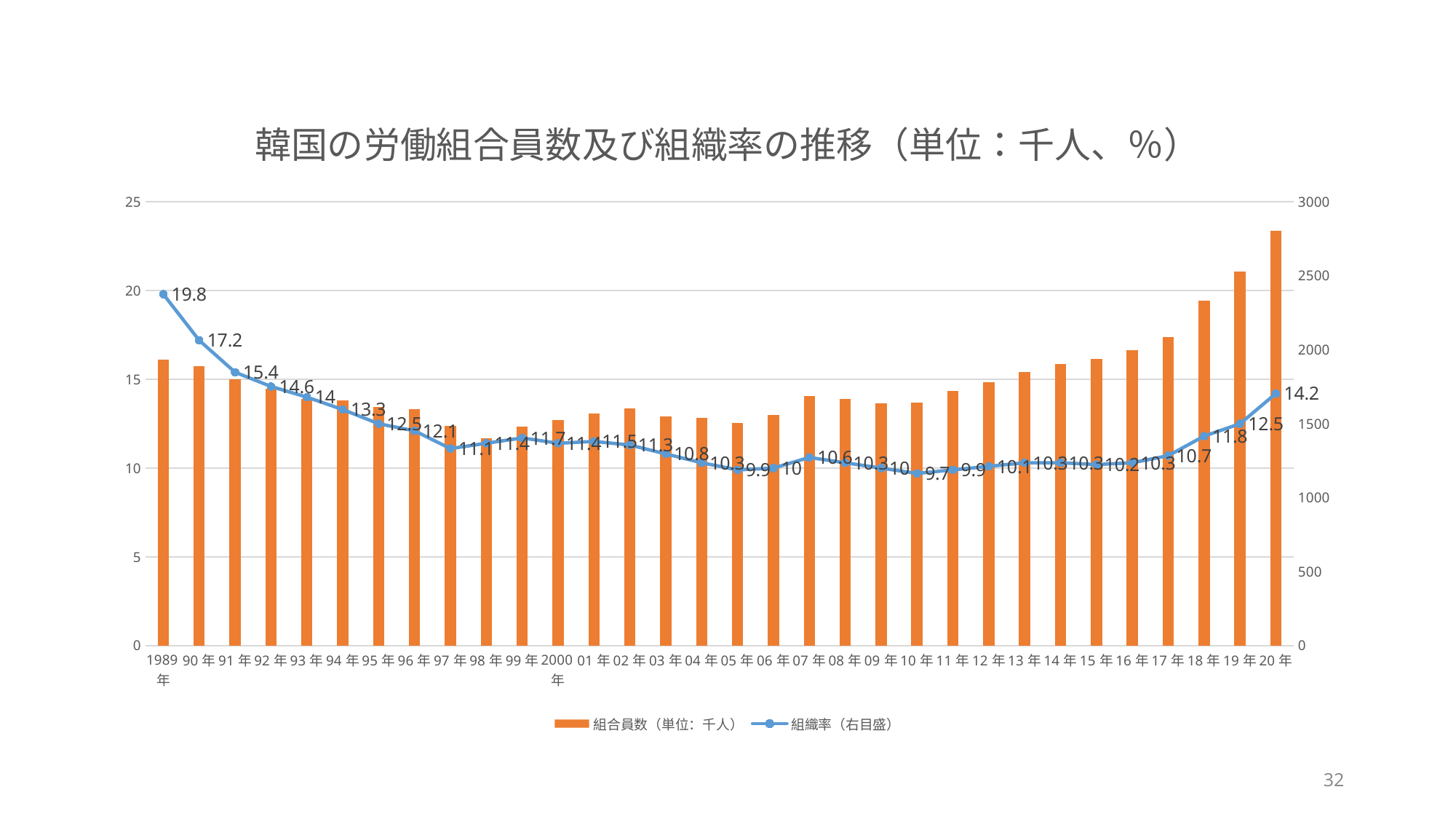
Which year has the higher 組織率, 18年 or 19年? 19年 What is the difference between the 組織率 values for 1989年 and 20年? 5.6 In which year is the 組織率 line at its highest? 1989年 What is the 組織率 value for 20年? 14.2 In which year is the 組織率 line at its lowest? 10年 What is the 組織率 value for 97年? 11.1 How many series does the legend list? 2 Do the 組合員数 bars rise or fall from 10年 to 20年? rise Is the 組合員数 bar for 18年 greater or less than 2500? less Which year has the tallest 組合員数 bar? 20年 Is the 組合員数 bar for 20年 greater or less than 2500? greater What is the 組織率 value for 1989年? 19.8